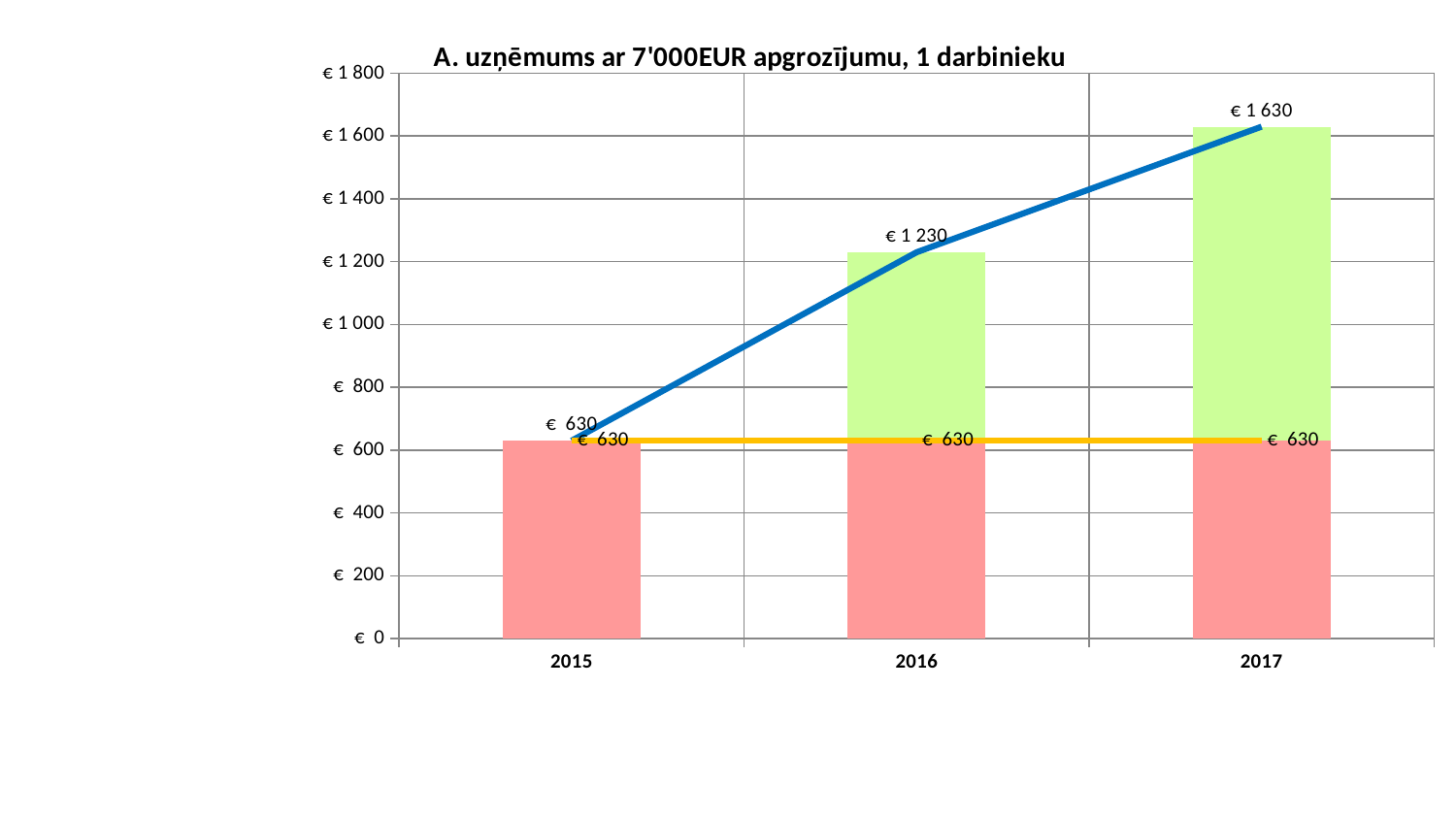
Is the value of the red bar for 2015 greater or less than € 800? less What value is labelled on the yellow line for 2015? € 630 Which is larger, the labelled value for 2016 (€ 1 230) or for 2017 (€ 1 630)? 2017 What is the difference between the labelled values for 2017 (€ 1 630) and 2016 (€ 1 230)? € 400 What value is labelled on the green bar for 2017? € 1 630 What is the title of the chart? A. uzņēmums ar 7'000EUR apgrozījumu, 1 darbinieku What kind of chart is shown on the slide? Combined bar and line chart What value is labelled on the green bar for 2016? € 1 230 Which year has the highest labelled value on the blue line? 2017 What is the difference between the top labelled value for 2017 (€ 1 630) and the yellow line value (€ 630)? € 1 000 How many years are shown on the x axis? 3 Does the blue line rise or fall from 2015 to 2017? rises